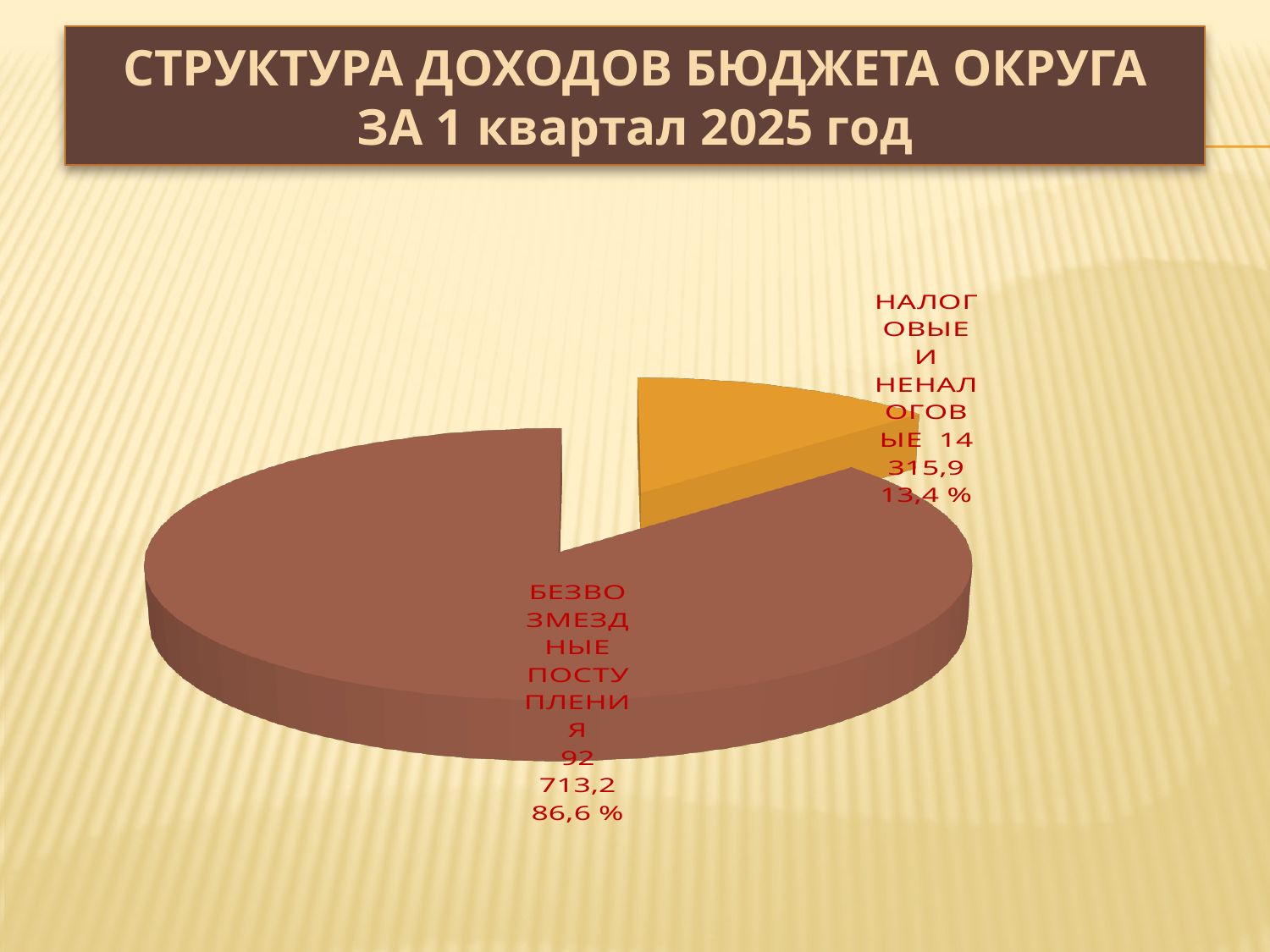
What is the value shown for НАЛОГОВЫЕ И НЕНАЛОГОВЫЕ? 14 315,9 Which category has the smallest slice of the pie? НАЛОГОВЫЕ И НЕНАЛОГОВЫЕ Which category has the largest slice of the pie? БЕЗВОЗМЕЗДНЫЕ ПОСТУПЛЕНИЯ What is the value shown for БЕЗВОЗМЕЗДНЫЕ ПОСТУПЛЕНИЯ? 92 713,2 What is the title of the slide containing the pie chart? СТРУКТУРА ДОХОДОВ БЮДЖЕТА ОКРУГА ЗА 1 квартал 2025 год What kind of chart is shown on the slide? pie chart Which is larger: БЕЗВОЗМЕЗДНЫЕ ПОСТУПЛЕНИЯ or НАЛОГОВЫЕ И НЕНАЛОГОВЫЕ? БЕЗВОЗМЕЗДНЫЕ ПОСТУПЛЕНИЯ What share of the pie does НАЛОГОВЫЕ И НЕНАЛОГОВЫЕ represent? 13,4 % What share of the pie does БЕЗВОЗМЕЗДНЫЕ ПОСТУПЛЕНИЯ represent? 86,6 % What is the difference between the values for БЕЗВОЗМЕЗДНЫЕ ПОСТУПЛЕНИЯ and НАЛОГОВЫЕ И НЕНАЛОГОВЫЕ? 78 397,3 How many slices does the pie chart have? 2 What colour is the slice for НАЛОГОВЫЕ И НЕНАЛОГОВЫЕ? orange